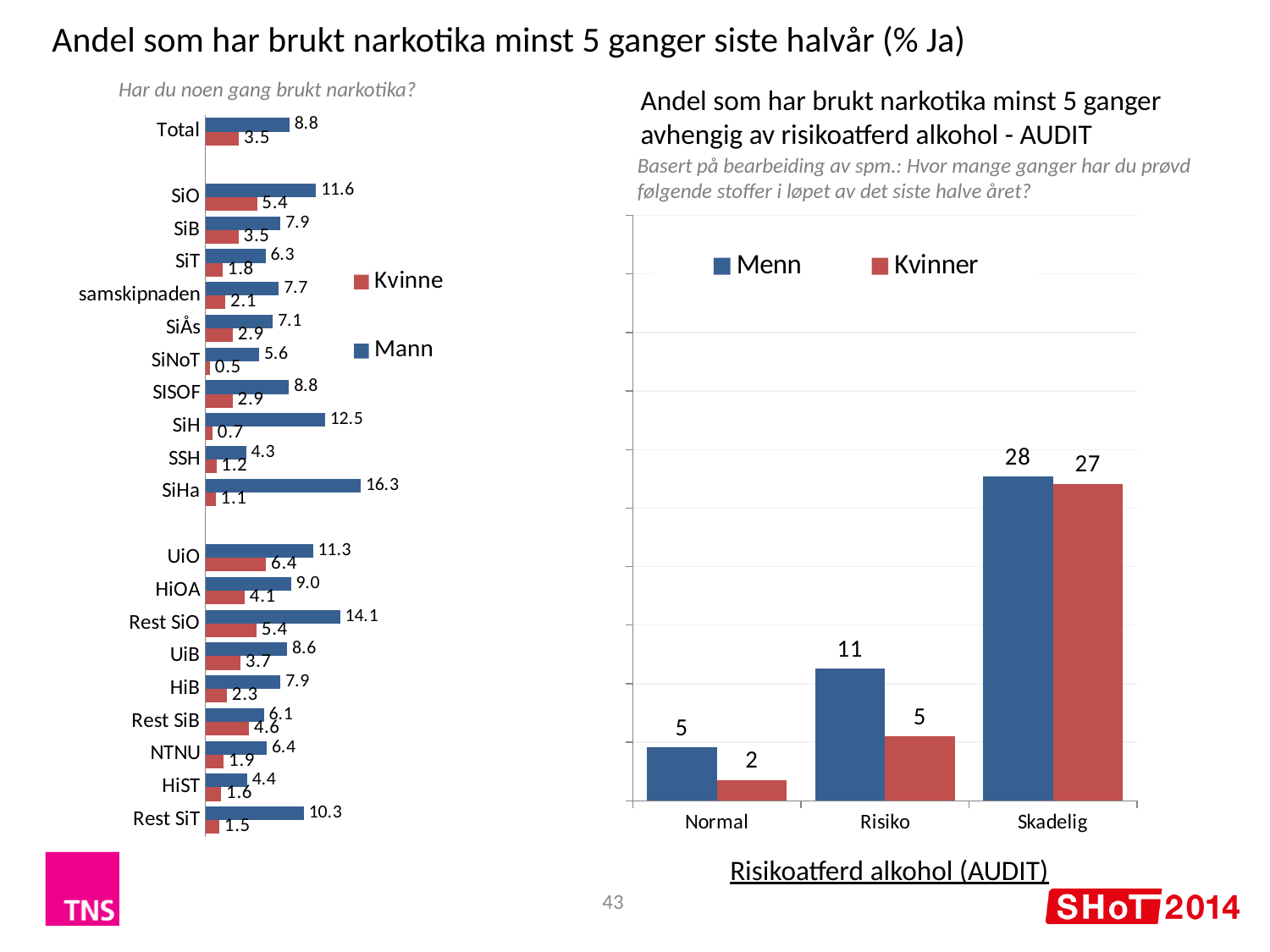
On the left chart, what is the value for Mann for SiHa? 16.3 On the right chart, what is the difference between Menn and Kvinner for Skadelig? 1 How many series does the legend of the right chart list? 2 How many categories are shown on the left chart? 20 On the right chart, what is the value for Menn for Risiko? 11 On the left chart, which category has the highest Mann value? SiHa On the left chart, which category has the lowest Kvinne value? SiNoT On the right chart, what is the value for Kvinner for Normal? 2 On the right chart, do the Menn values rise or fall from Normal to Skadelig? rise On the left chart, what is the value for Kvinne for UiO? 6.4 On the left chart, which is larger: the Mann value for SiH or the Mann value for SiO? SiH On the left chart, what is the difference between the Mann and Kvinne values for Total? 5.3